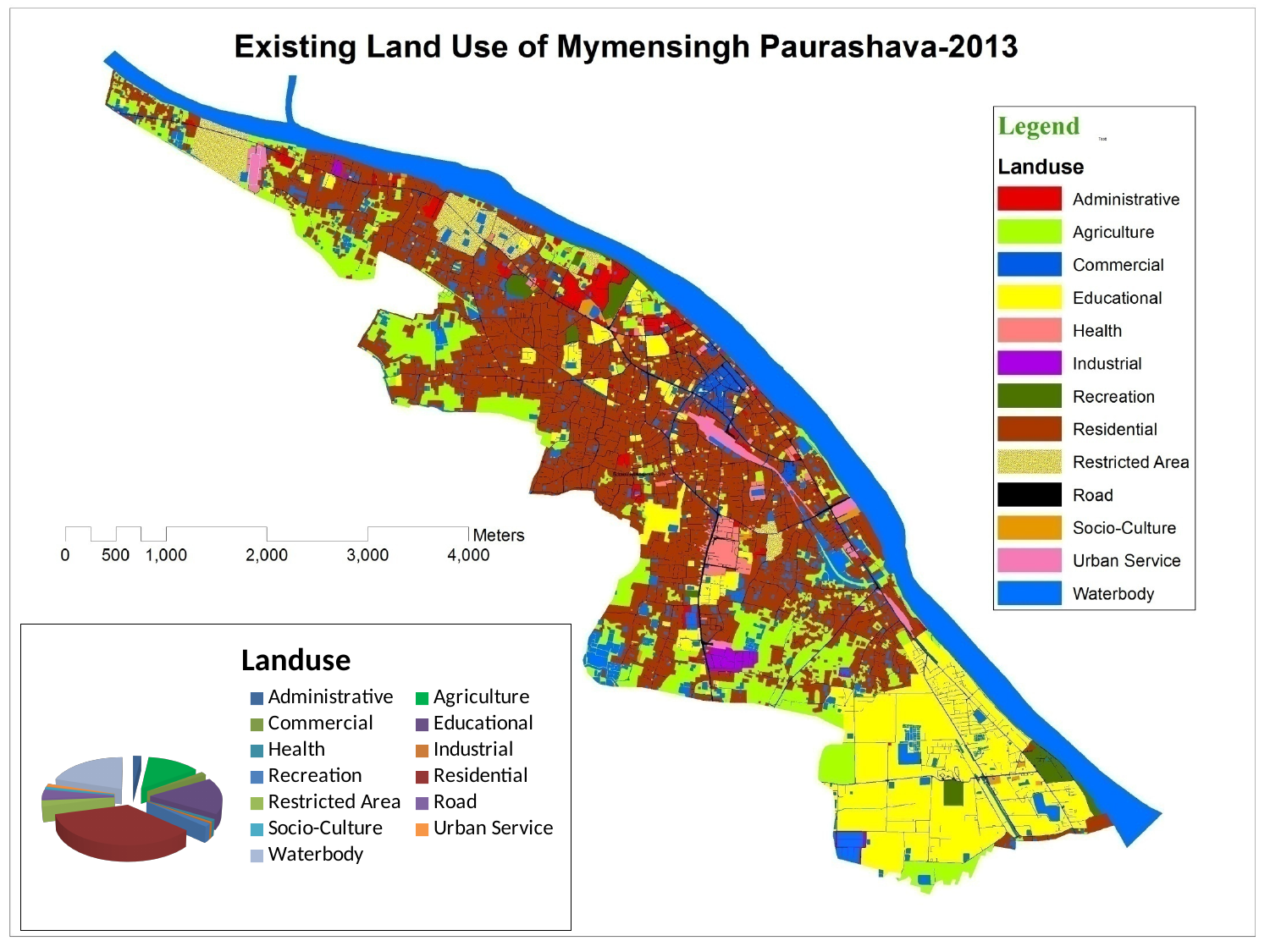
How many land use categories does the pie chart's legend list? 13 In the pie chart, which slice is larger, Waterbody or Health? Waterbody Which land use category has the largest slice in the pie chart? Residential In the pie chart, which slice is larger, Agriculture or Industrial? Agriculture In the pie chart, which slice is larger, Residential or Agriculture? Residential What kind of chart is shown in the bottom-left panel of the slide? pie chart What colour is used for the Residential slice in the pie chart? dark red What is the title of the pie chart in the bottom-left panel? Landuse